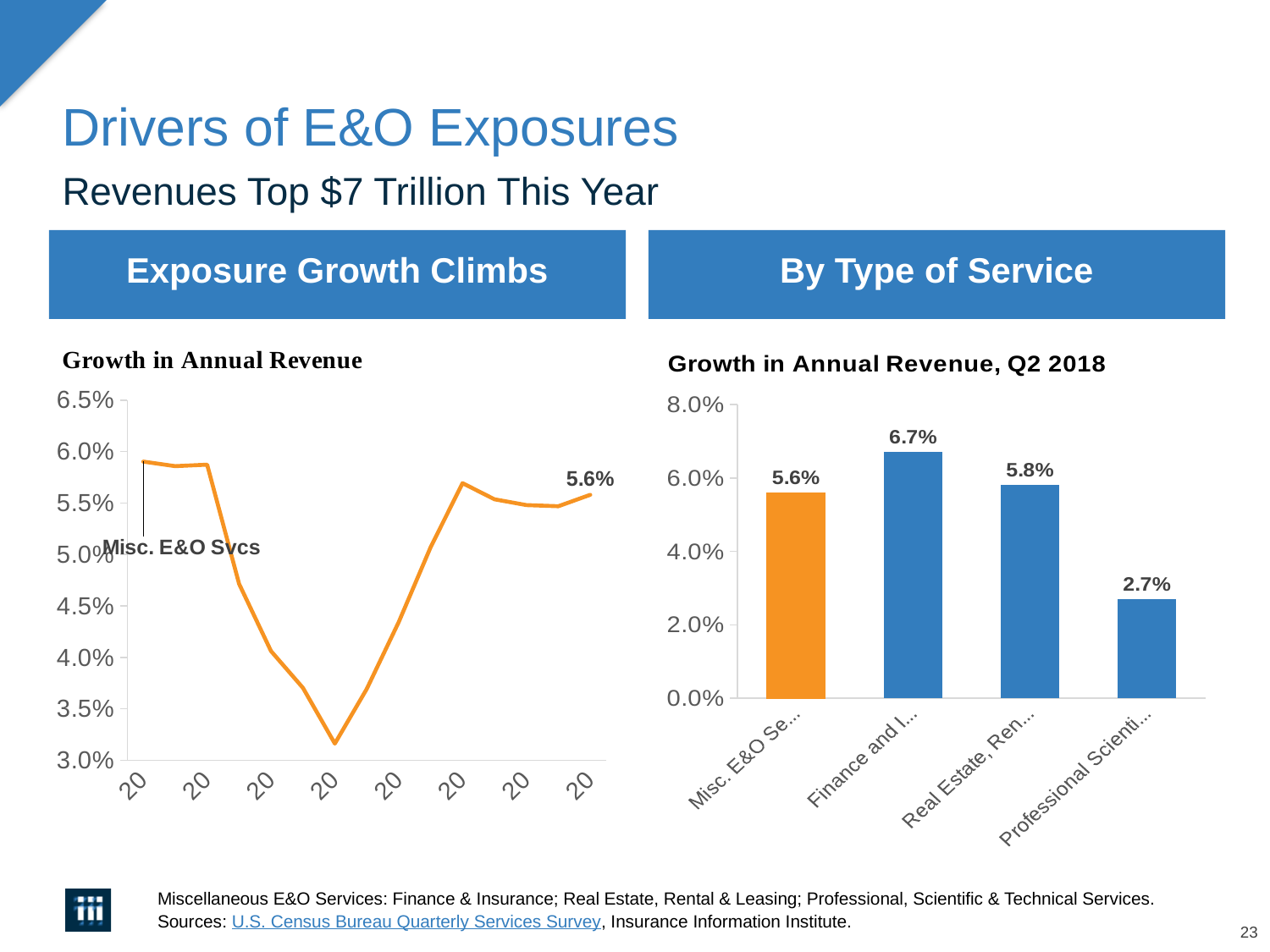
In the 'Growth in Annual Revenue, Q2 2018' chart, which is larger: Real Estate, Rental & Leasing or Misc. E&O Services? Real Estate, Rental & Leasing In the 'Growth in Annual Revenue, Q2 2018' chart, what is the value for Finance and Insurance? 6.7% What kind of chart is the 'Growth in Annual Revenue' chart on the left? Line chart In the 'Growth in Annual Revenue, Q2 2018' chart, what is the value for Misc. E&O Services? 5.6% In the 'Growth in Annual Revenue, Q2 2018' chart, which category has the lowest growth? Professional, Scientific & Technical Services In the 'Growth in Annual Revenue, Q2 2018' chart, what is the value for Professional, Scientific & Technical Services? 2.7% In the 'Growth in Annual Revenue, Q2 2018' chart, which category has the highest growth? Finance and Insurance How many bars are shown in the 'Growth in Annual Revenue, Q2 2018' chart? 4 In the 'Growth in Annual Revenue' line chart on the left, what is the value shown by the data label at the end of the line? 5.6% What kind of chart is the 'Growth in Annual Revenue, Q2 2018' chart on the right? Bar chart In the 'Growth in Annual Revenue, Q2 2018' chart, what is the difference between Finance and Insurance and Misc. E&O Services? 1.1 percentage points In the 'Growth in Annual Revenue' line chart on the left, is the lowest point of the line greater or less than 3.5%? less